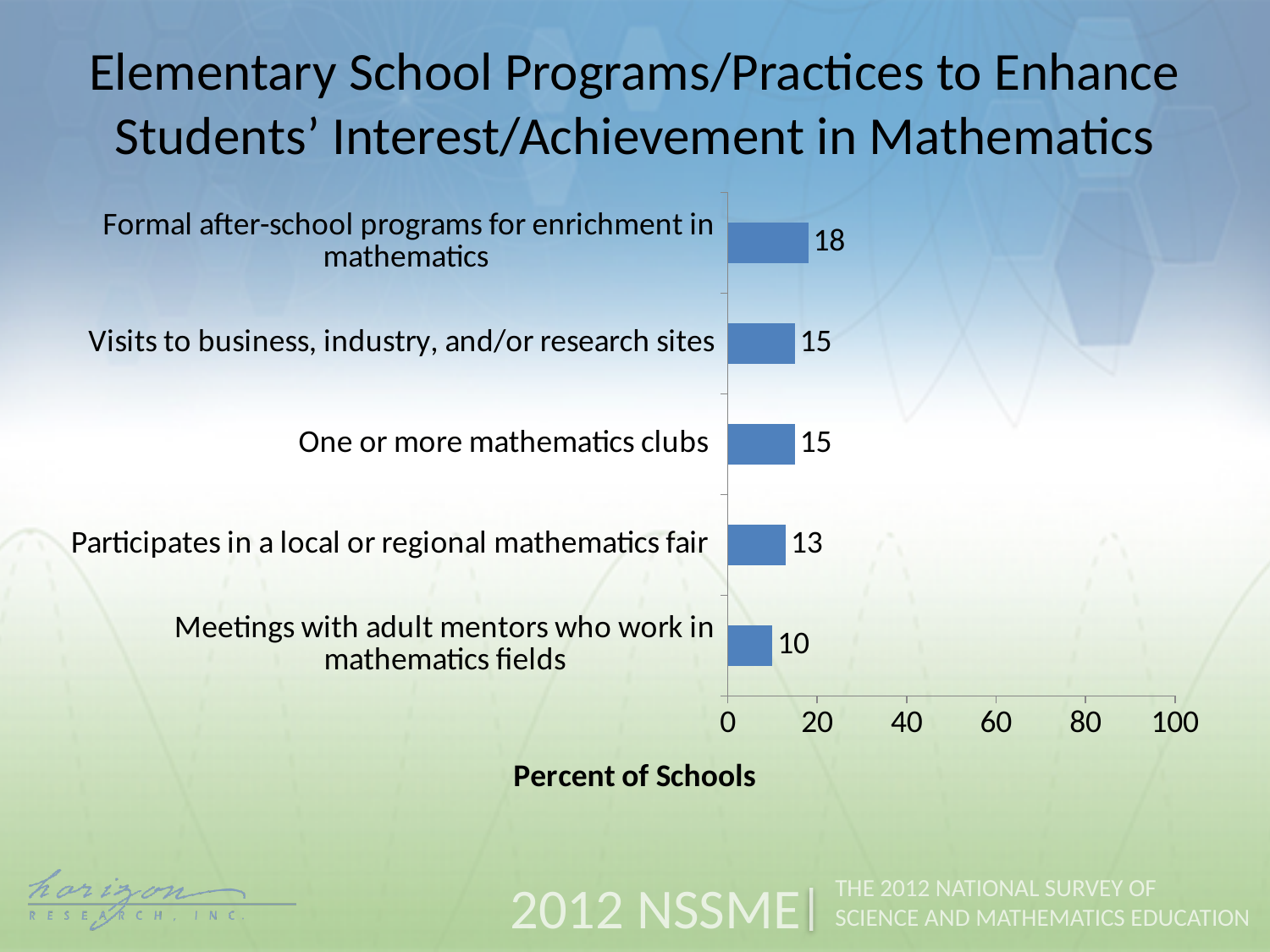
What is the label of the horizontal axis? Percent of Schools What percent of schools have formal after-school programs for enrichment in mathematics? 18 Which has a higher percent of schools: visits to business, industry, and/or research sites or participates in a local or regional mathematics fair? Visits to business, industry, and/or research sites What is the difference in percent of schools between formal after-school programs for enrichment in mathematics and meetings with adult mentors who work in mathematics fields? 8 Which program/practice has the highest percent of schools? Formal after-school programs for enrichment in mathematics What percent of schools report meetings with adult mentors who work in mathematics fields? 10 What percent of schools have one or more mathematics clubs? 15 How many programs/practices are shown in the chart? 5 What kind of chart is shown on the slide? Bar chart What percent of schools participate in a local or regional mathematics fair? 13 Which program/practice has the lowest percent of schools? Meetings with adult mentors who work in mathematics fields Is the value for formal after-school programs for enrichment in mathematics greater or less than 20? less